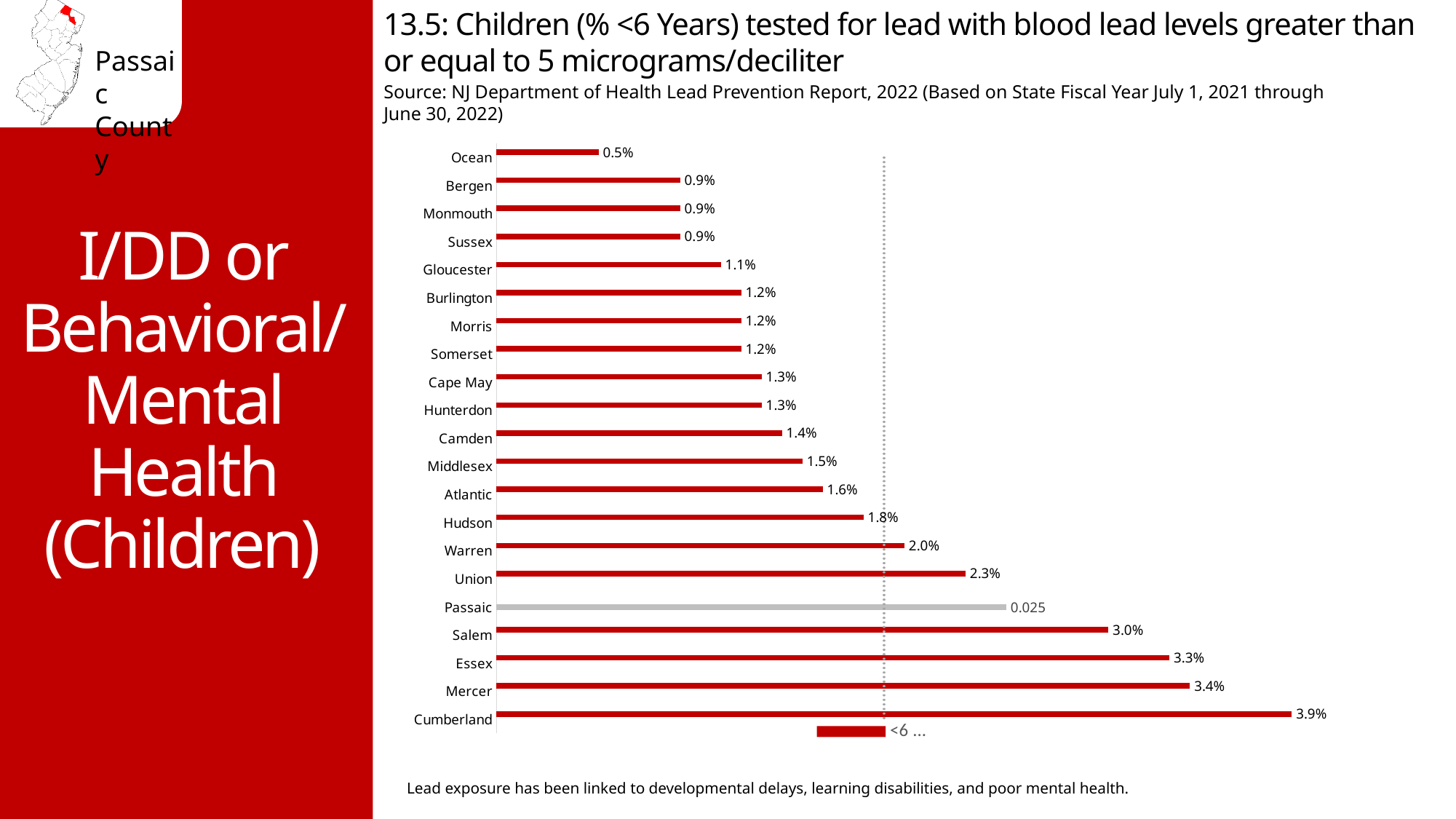
Which is larger, the value for Warren or the value for Union? Union Which county has the lowest percentage of children with elevated blood lead levels? Ocean How many counties are plotted in the chart? 21 What is the value shown for Salem? 3.0% Which county has the highest percentage of children with elevated blood lead levels? Cumberland What colour is the bar for Passaic, which differs from the other bars? grey What is the value shown for Camden? 1.4% What type of chart is shown on the slide? bar chart What is the difference between the values for Cumberland and Ocean? 3.4% What is the data label shown for Passaic? 0.025 Which is larger, the value for Hudson or the value for Atlantic? Hudson What is the difference between the values for Salem and Union? 0.7%